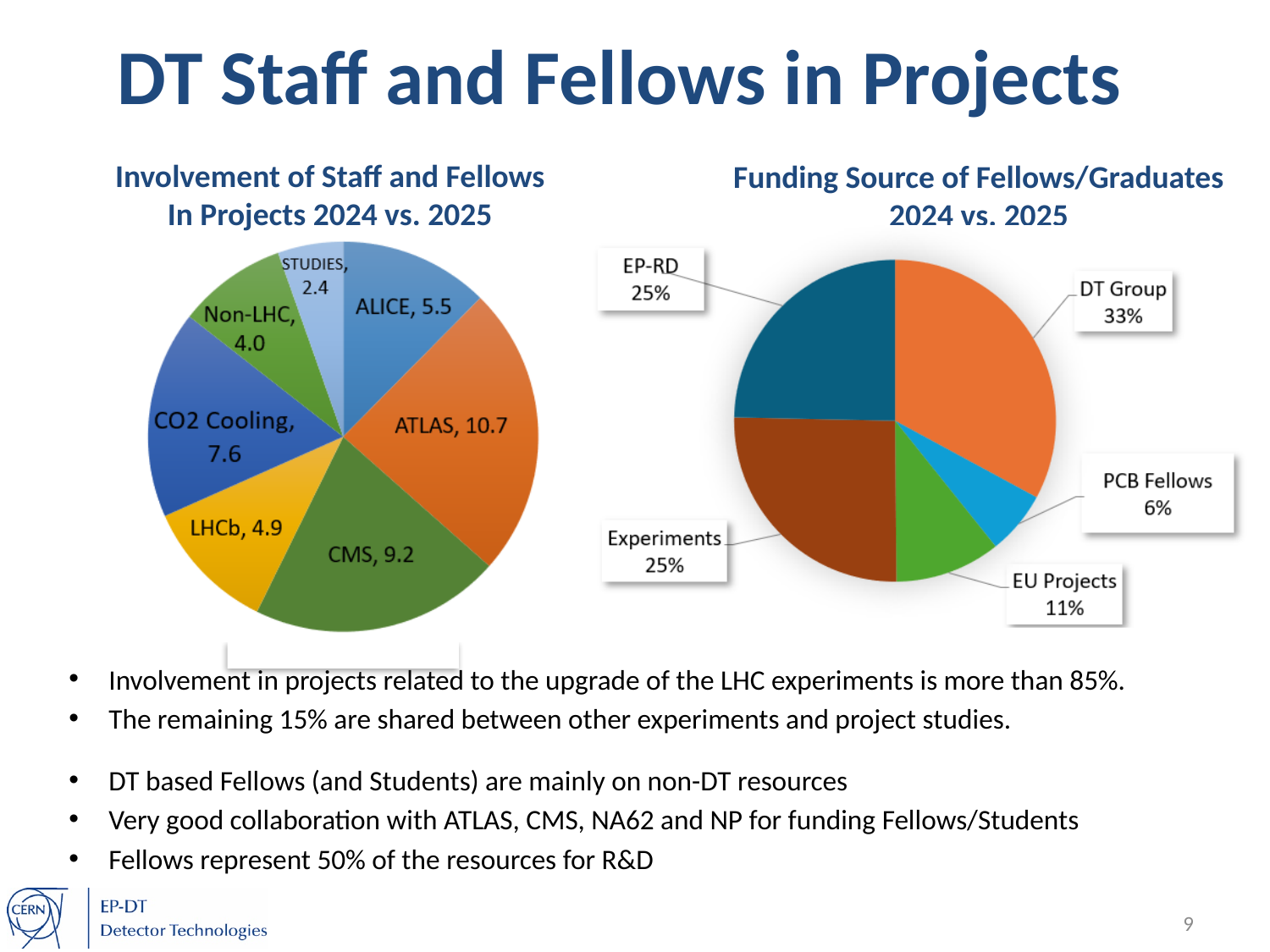
What kind of chart is the 'Funding Source of Fellows/Graduates 2024 vs. 2025' chart? Pie chart In the 'Involvement of Staff and Fellows In Projects 2024 vs. 2025' chart, which category has the largest value? ATLAS In the 'Involvement of Staff and Fellows In Projects 2024 vs. 2025' chart, what is the value for CO2 Cooling? 7.6 In the 'Involvement of Staff and Fellows In Projects 2024 vs. 2025' chart, what is the value for ATLAS? 10.7 In the 'Involvement of Staff and Fellows In Projects 2024 vs. 2025' chart, which is larger, LHCb or ALICE? ALICE In the 'Involvement of Staff and Fellows In Projects 2024 vs. 2025' chart, which category has the smallest value? STUDIES In the 'Funding Source of Fellows/Graduates 2024 vs. 2025' chart, what share is DT Group? 33% In the 'Involvement of Staff and Fellows In Projects 2024 vs. 2025' chart, what is the difference between the ATLAS and CMS values? 1.5 In the 'Funding Source of Fellows/Graduates 2024 vs. 2025' chart, what is the difference between the DT Group and EU Projects shares? 22% How many slices are in the 'Funding Source of Fellows/Graduates 2024 vs. 2025' chart? 5 How many categories are shown in the 'Involvement of Staff and Fellows In Projects 2024 vs. 2025' chart? 7 In the 'Funding Source of Fellows/Graduates 2024 vs. 2025' chart, which source has the smallest share? PCB Fellows